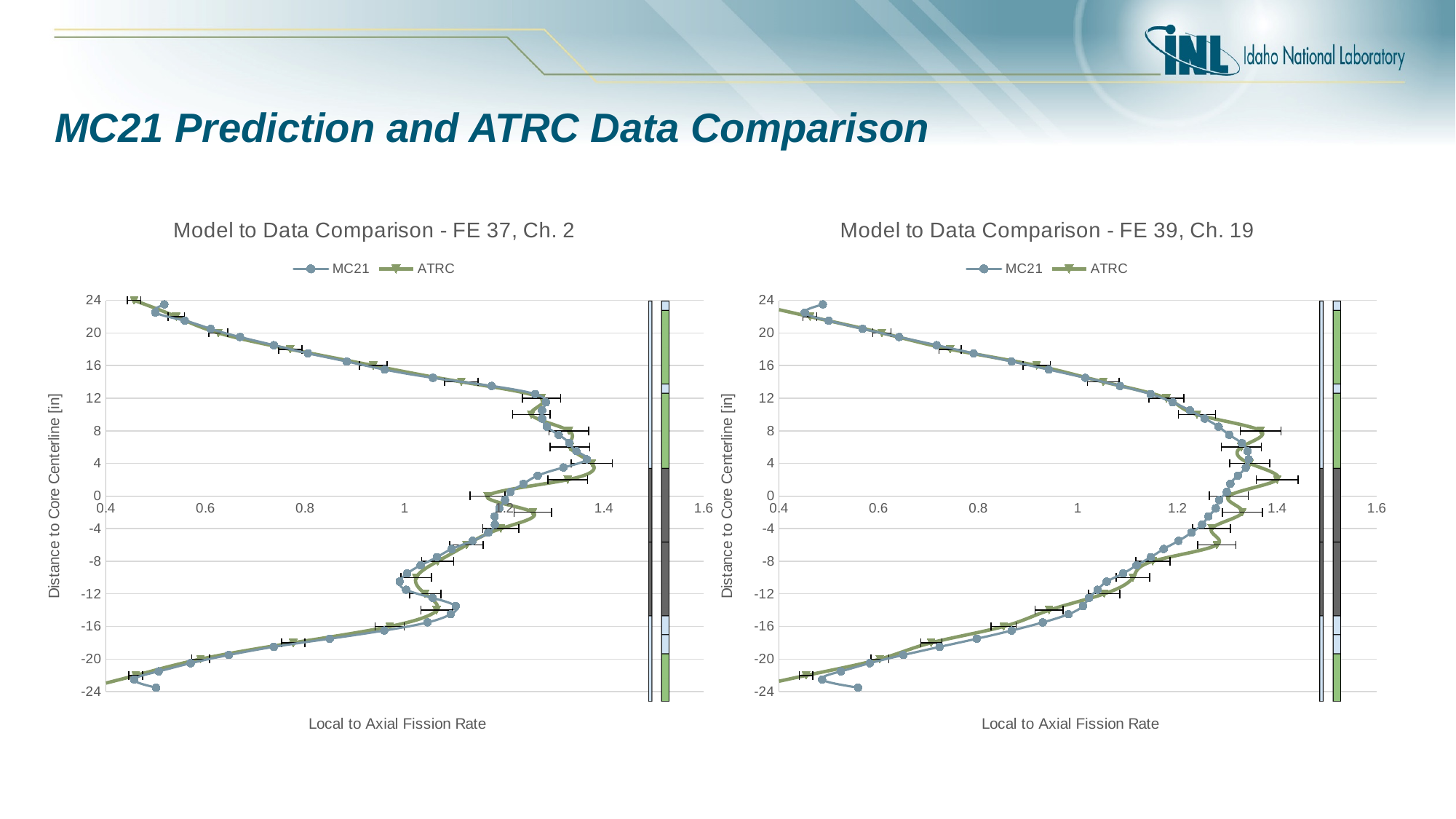
In the right chart, 'Model to Data Comparison - FE 39, Ch. 19', is the MC21 value at -24 inches from the core centerline greater or less than 0.8? less What is the x-axis label of the right chart, 'Model to Data Comparison - FE 39, Ch. 19'? Local to Axial Fission Rate In the left chart, 'Model to Data Comparison - FE 37, Ch. 2', is the ATRC value at 8 inches from the core centerline greater or less than 1.2? greater In the right chart, 'Model to Data Comparison - FE 39, Ch. 19', does the ATRC fission rate rise or fall as the distance to core centerline increases from -24 to -8 inches? rise In the left chart, 'Model to Data Comparison - FE 37, Ch. 2', is the ATRC value at 4 inches from the core centerline greater or less than 1.2? greater What are the two series named in the legend of the left chart, 'Model to Data Comparison - FE 37, Ch. 2'? MC21 and ATRC How many series does the legend of the right chart, 'Model to Data Comparison - FE 39, Ch. 19', list? 2 In the left chart, 'Model to Data Comparison - FE 37, Ch. 2', does the MC21 fission rate rise or fall as the distance to core centerline increases from 12 to 24 inches? fall What kind of chart is the left chart, 'Model to Data Comparison - FE 37, Ch. 2'? Line chart